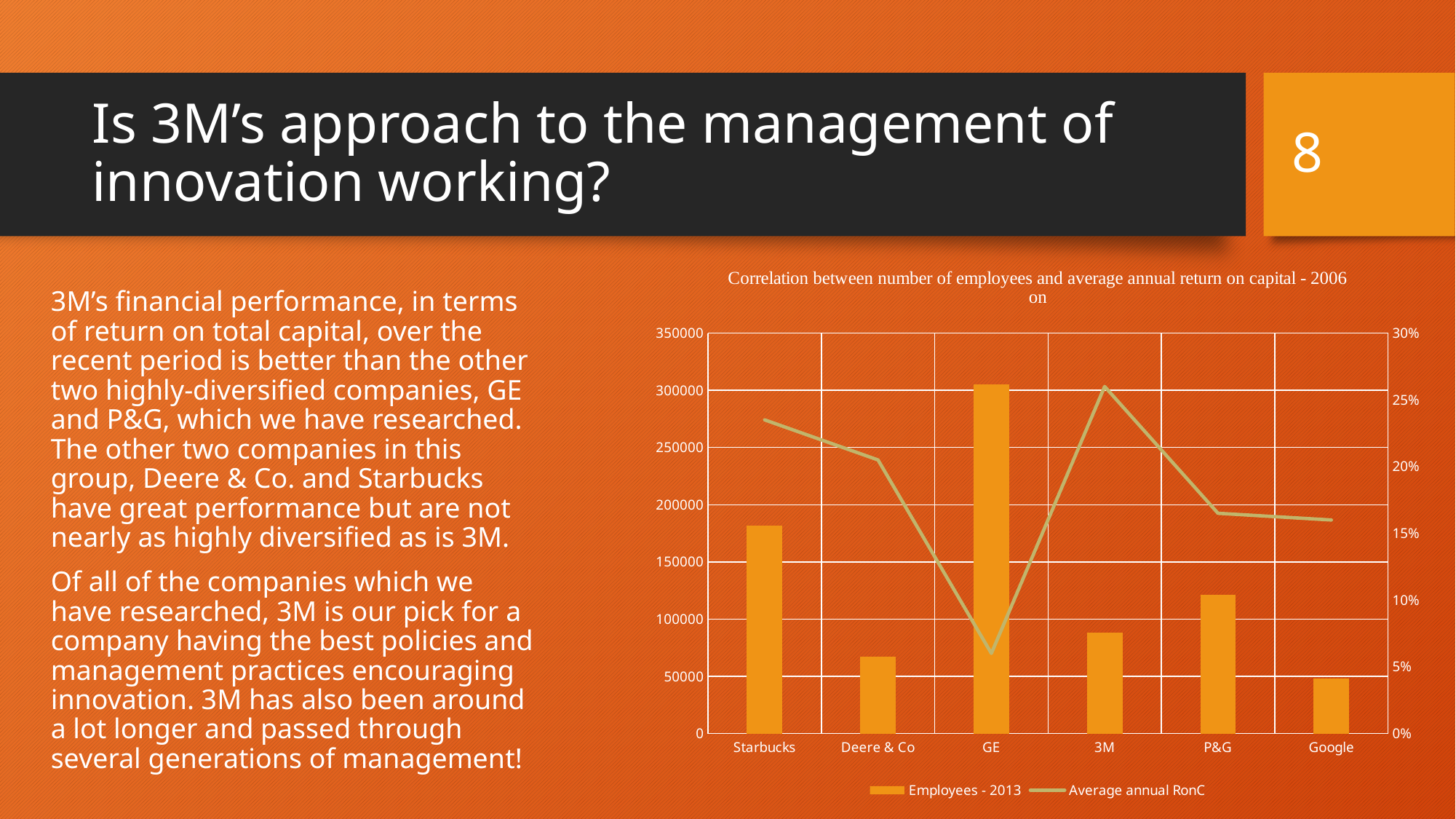
Is the Employees - 2013 value for Starbucks greater or less than 150000? greater How many series does the chart legend list? 2 Which company has the lowest average annual RonC according to the line? GE Which company has the highest number of employees in 2013 according to the bars? GE What are the two series named in the chart legend? Employees - 2013 and Average annual RonC Is the average annual RonC for GE greater or less than 10%? less Which company has more employees in 2013, Starbucks or P&G? Starbucks Which company has the highest average annual RonC according to the line? 3M How many companies are shown on the x axis of the chart? 6 Which company has the lowest number of employees in 2013 according to the bars? Google Is the Employees - 2013 value for 3M greater or less than 100000? less What kind of chart is shown on the slide? A combination bar and line chart